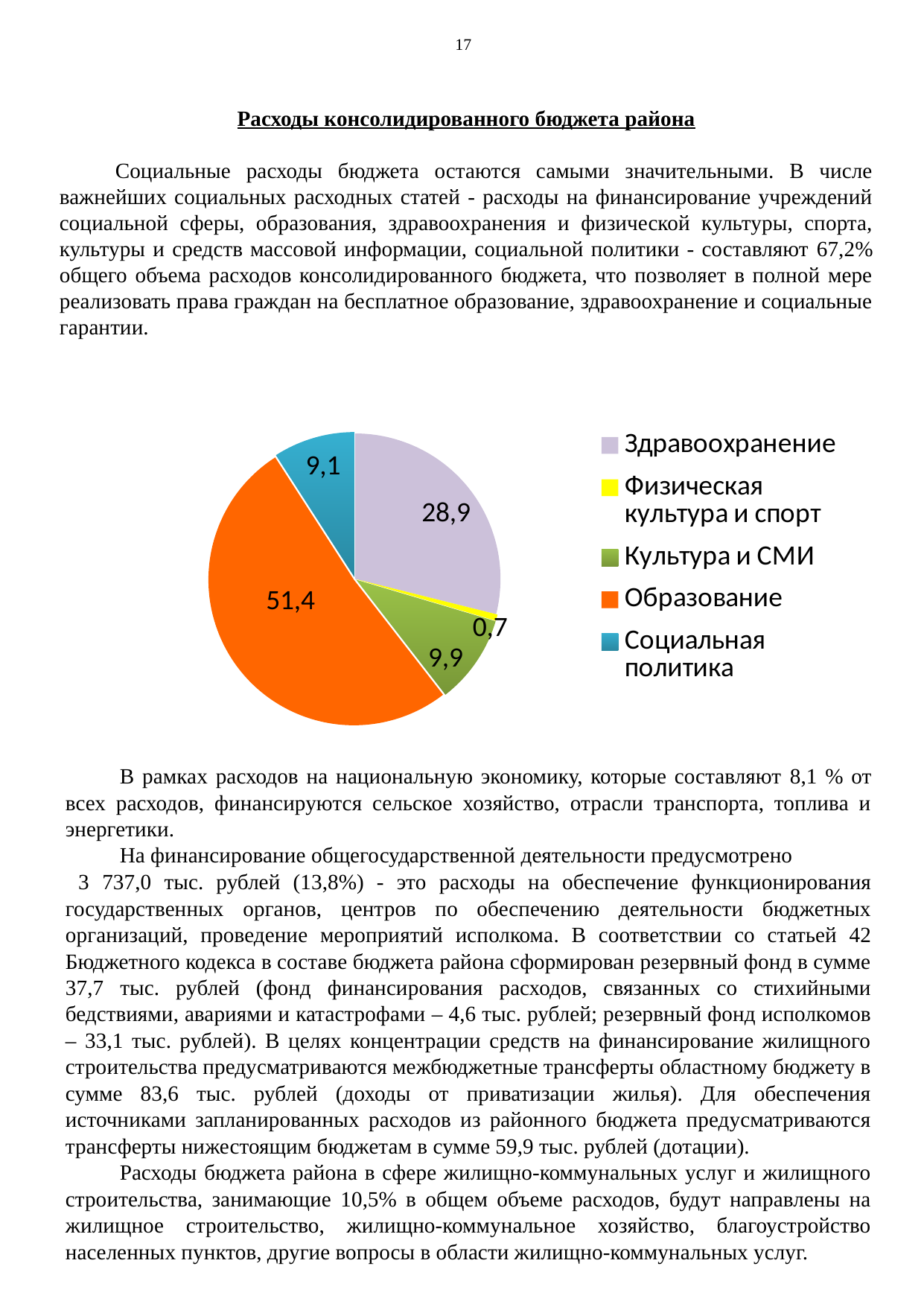
Which category has the smallest slice in the pie chart? Физическая культура и спорт What is the difference between the values for Культура и СМИ and Социальная политика? 0,8 What is the value shown for Социальная политика in the pie chart? 9,1 What colour is the slice for Образование in the pie chart? orange Which category has the largest slice in the pie chart? Образование What is the value shown for Образование in the pie chart? 51,4 How many categories does the pie chart show? 5 What is the value shown for Физическая культура и спорт in the pie chart? 0,7 What is the value shown for Здравоохранение in the pie chart? 28,9 Which is larger, the slice for Культура и СМИ or the slice for Социальная политика? Культура и СМИ What is the difference between the values for Образование and Здравоохранение? 22,5 What type of chart is shown on the slide? pie chart